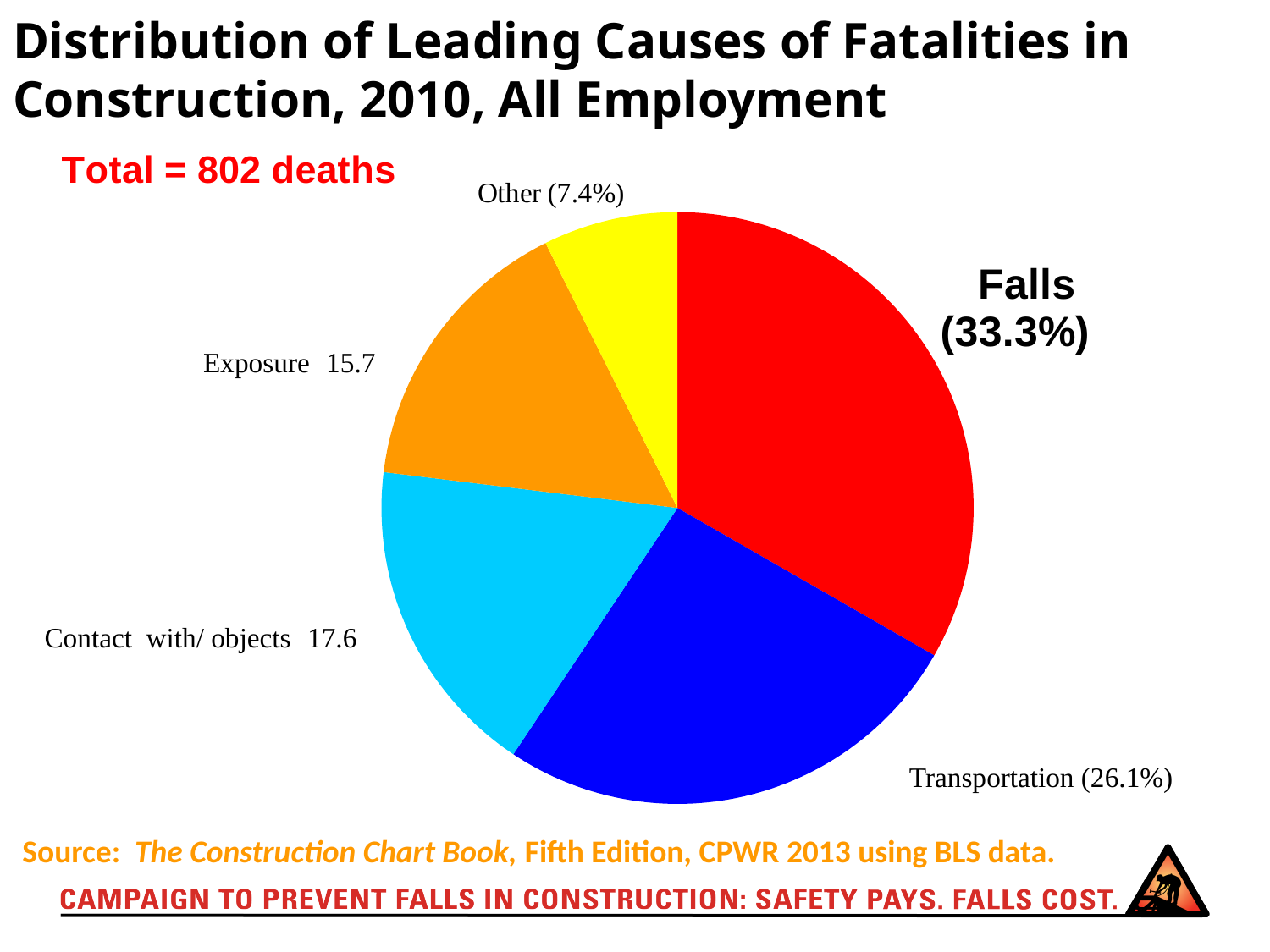
What value is shown for Exposure? 15.7 What total number of deaths does the slide state the chart represents? 802 deaths What percentage of fatalities is shown for Transportation? 26.1% What type of chart is shown on the slide? Pie chart What value is shown for Contact with/ objects? 17.6 How many percentage points larger is the Falls share than the Transportation share? 7.2 What share of the pie is labelled Other? 7.4% Which cause of fatalities has the largest slice of the pie? Falls What share of construction fatalities in 2010 is attributed to Falls? 33.3% Which is larger, the share for Contact with/ objects or the share for Exposure? Contact with/ objects How many categories are shown in the pie chart? 5 Which category has the smallest slice of the pie? Other